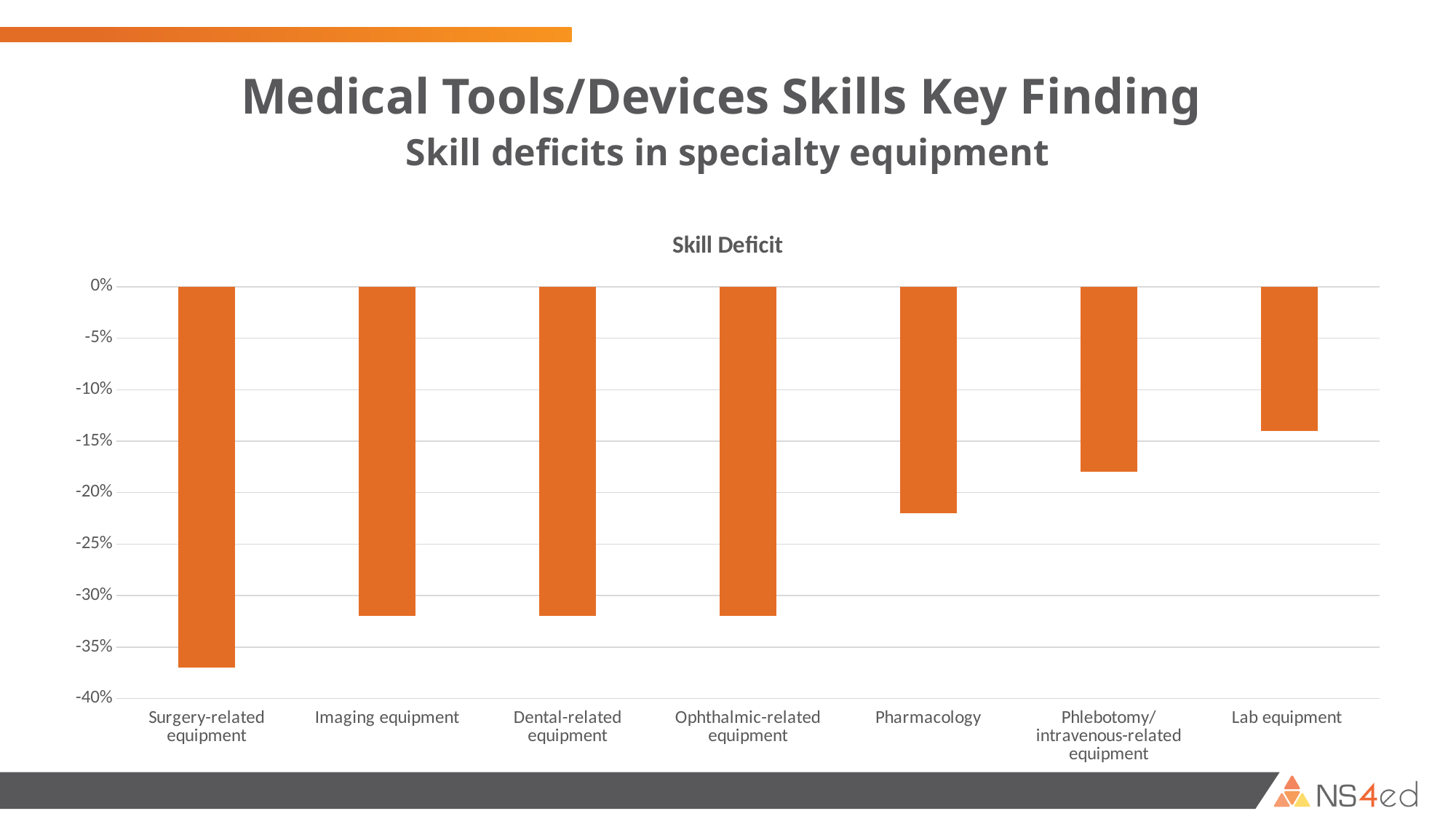
Is the value for Surgery-related equipment greater or less than -35%? less Which category has the lowest value (the largest skill deficit)? Surgery-related equipment Is the value for Imaging equipment greater or less than -30%? less Do the values rise or fall moving from left to right along the x axis? rise Which category has the highest value (the smallest skill deficit)? Lab equipment Which has the larger value, Pharmacology or Phlebotomy/intravenous-related equipment? Phlebotomy/intravenous-related equipment Is the value for Lab equipment greater or less than -15%? greater What kind of chart is shown on the slide? bar chart How many categories are plotted on the chart? 7 What is the title of the chart? Skill Deficit